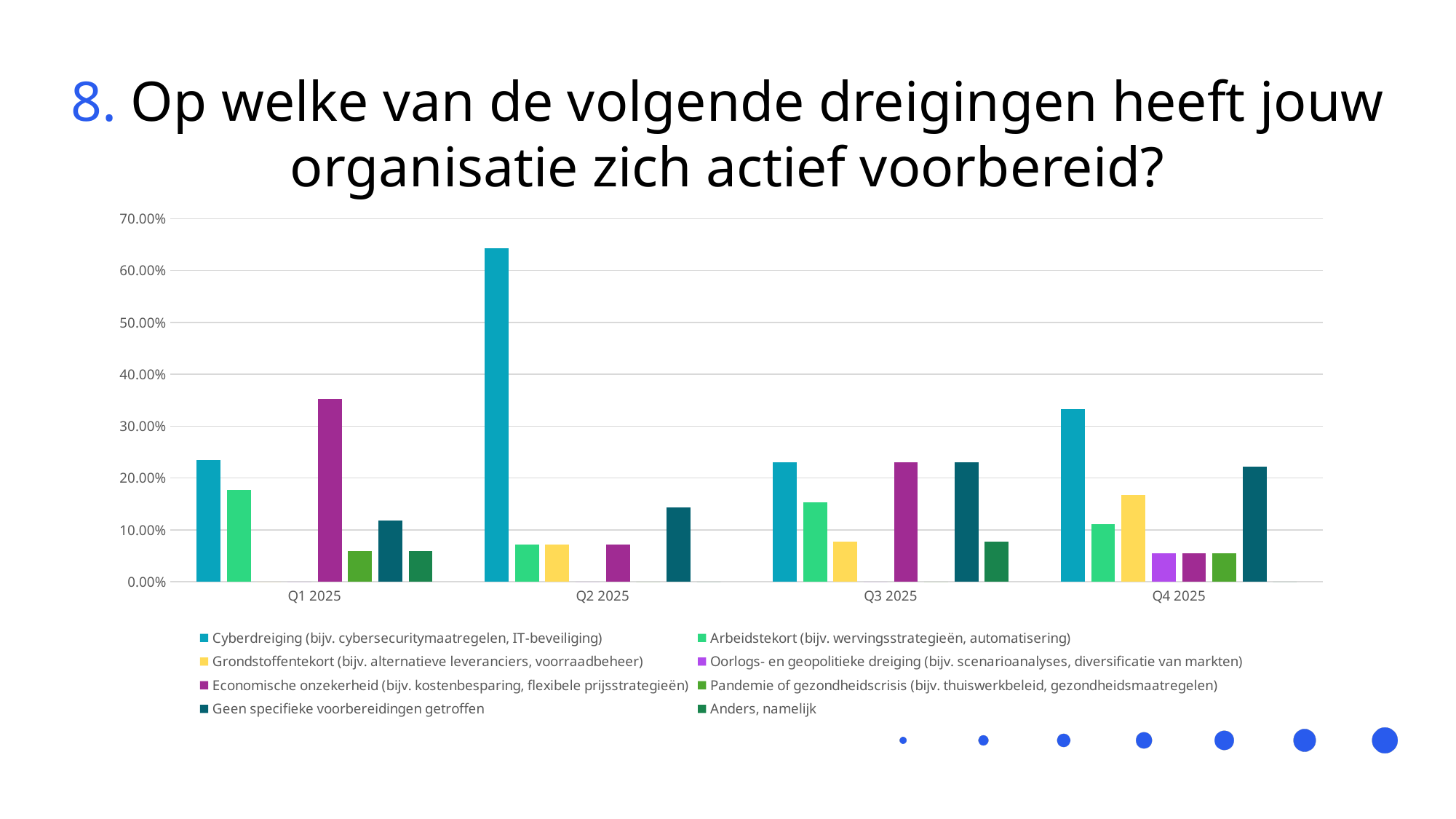
How many quarters are shown along the x axis? 4 In Q4 2025, which series has the highest bar? Cyberdreiging Is the value for Geen specifieke voorbereidingen getroffen in Q4 2025 greater or less than 20.00%? greater How many series does the legend list? 8 Which is larger for Grondstoffentekort: Q3 2025 or Q4 2025? Q4 2025 Is the value for Economische onzekerheid in Q1 2025 greater or less than 30.00%? greater Does the Arbeidstekort value rise or fall from Q1 2025 to Q2 2025? fall What kind of chart is shown on the slide? bar chart Is the value for Cyberdreiging in Q2 2025 greater or less than 60.00%? greater In Q1 2025, which is larger: Cyberdreiging or Economische onzekerheid? Economische onzekerheid In which quarter is the Cyberdreiging bar the highest? Q2 2025